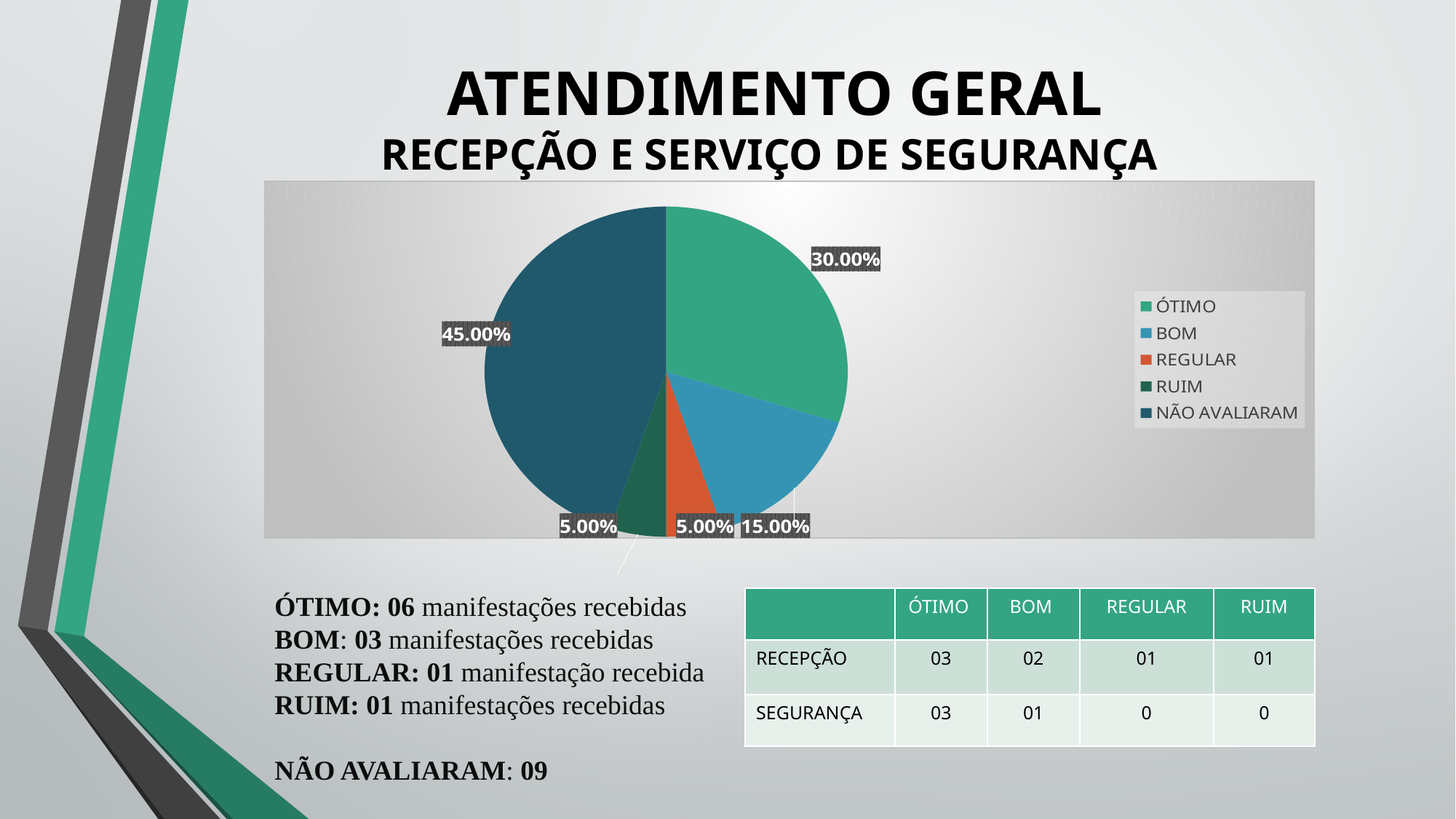
Which category has the largest slice of the pie? NÃO AVALIARAM How many entries does the legend list? 5 What percentage of the pie does ÓTIMO represent? 30.00% What percentage of the pie does BOM represent? 15.00% What kind of chart is shown on the slide? pie chart How many slices does the pie chart have? 5 Which legend entry is shown in orange? REGULAR Which slice is larger, ÓTIMO or BOM? ÓTIMO What is the combined share of ÓTIMO and BOM? 45.00% What percentage of the pie does NÃO AVALIARAM represent? 45.00% What is the difference in percentage points between NÃO AVALIARAM and ÓTIMO? 15.00% What percentage of the pie does REGULAR represent? 5.00%